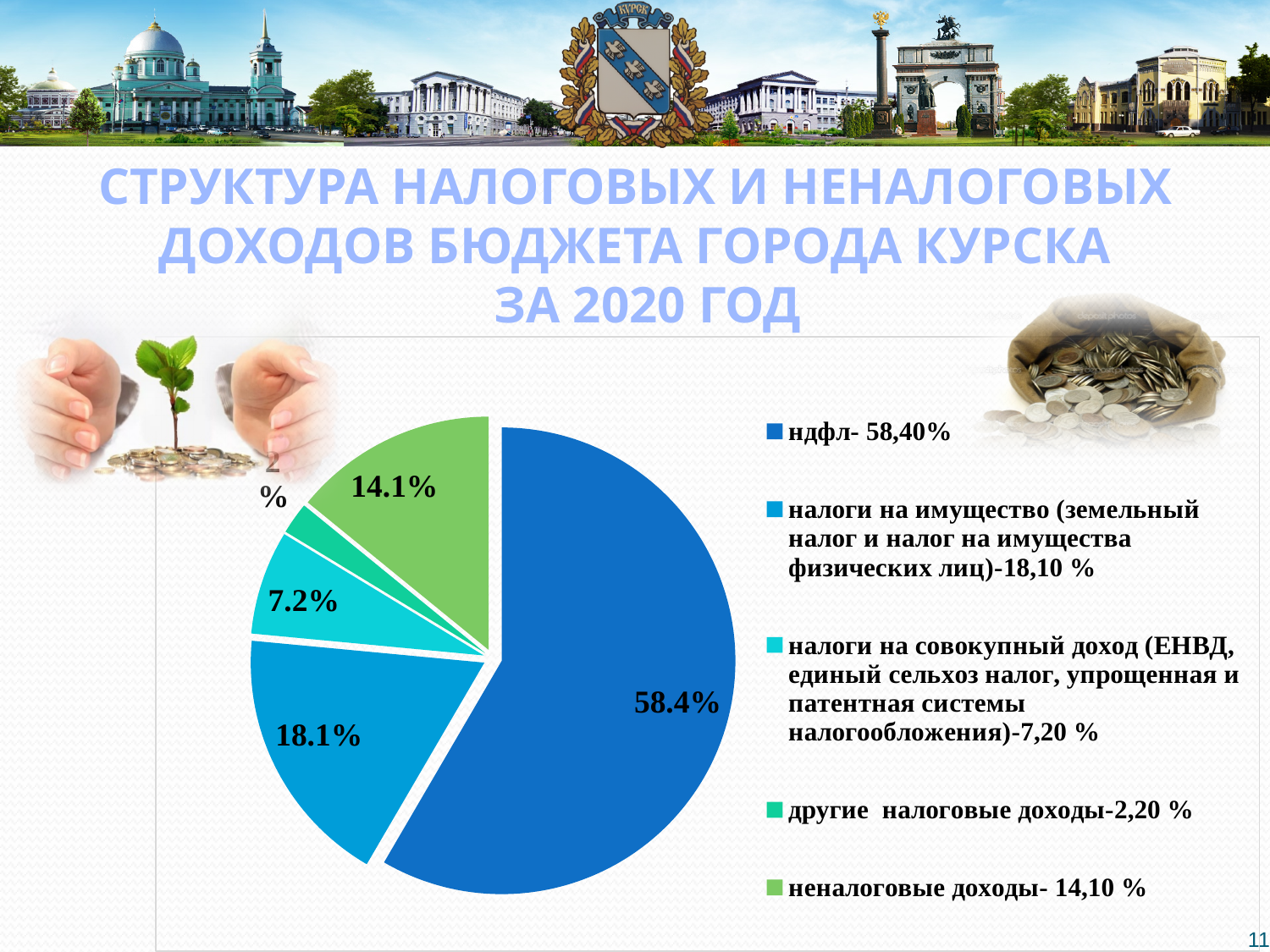
Which category has the smallest slice of the pie? другие налоговые доходы Which is larger: the slice for налоги на имущество or the slice for неналоговые доходы? налоги на имущество What percentage is shown for налоги на совокупный доход? 7.2% Which category has the largest slice of the pie? НДФЛ How many entries does the legend list? 5 By how many percentage points does the НДФЛ slice exceed the налоги на имущество slice? 40.3 What share of the pie does НДФЛ account for? 58.4% What percentage is shown for неналоговые доходы? 14.1% What percentage is shown for налоги на имущество (земельный налог и налог на имущества физических лиц)? 18.1% How many slices does the pie chart have? 5 What kind of chart is shown on the slide? pie chart According to the legend, what share do другие налоговые доходы make up? 2,20 %